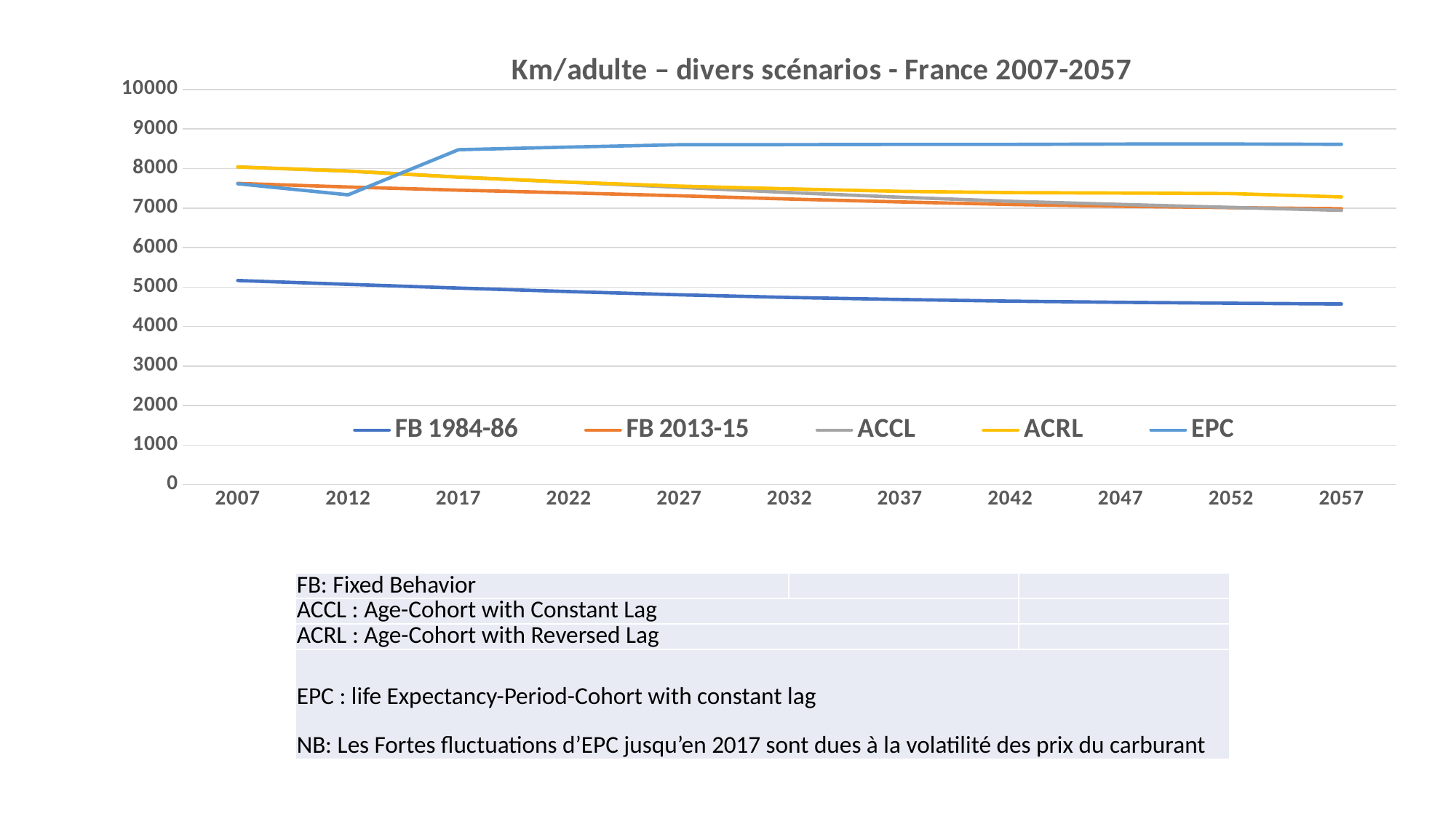
How many series does the legend list? 5 What is the title of the chart? Km/adulte – divers scénarios - France 2007-2057 Is the value for EPC in 2057 greater or less than 8000? greater Is the value for FB 1984-86 in 2057 greater or less than 5000? less What kind of chart is shown on the slide? line chart Does the FB 1984-86 series rise or fall from 2007 to 2057? fall Is the value for ACRL in 2057 greater or less than 7000? greater In 2057, which series is larger, EPC or ACRL? EPC Which series has the highest value in 2057? EPC Which series has the lowest value in 2057? FB 1984-86 How many years are marked along the x axis? 11